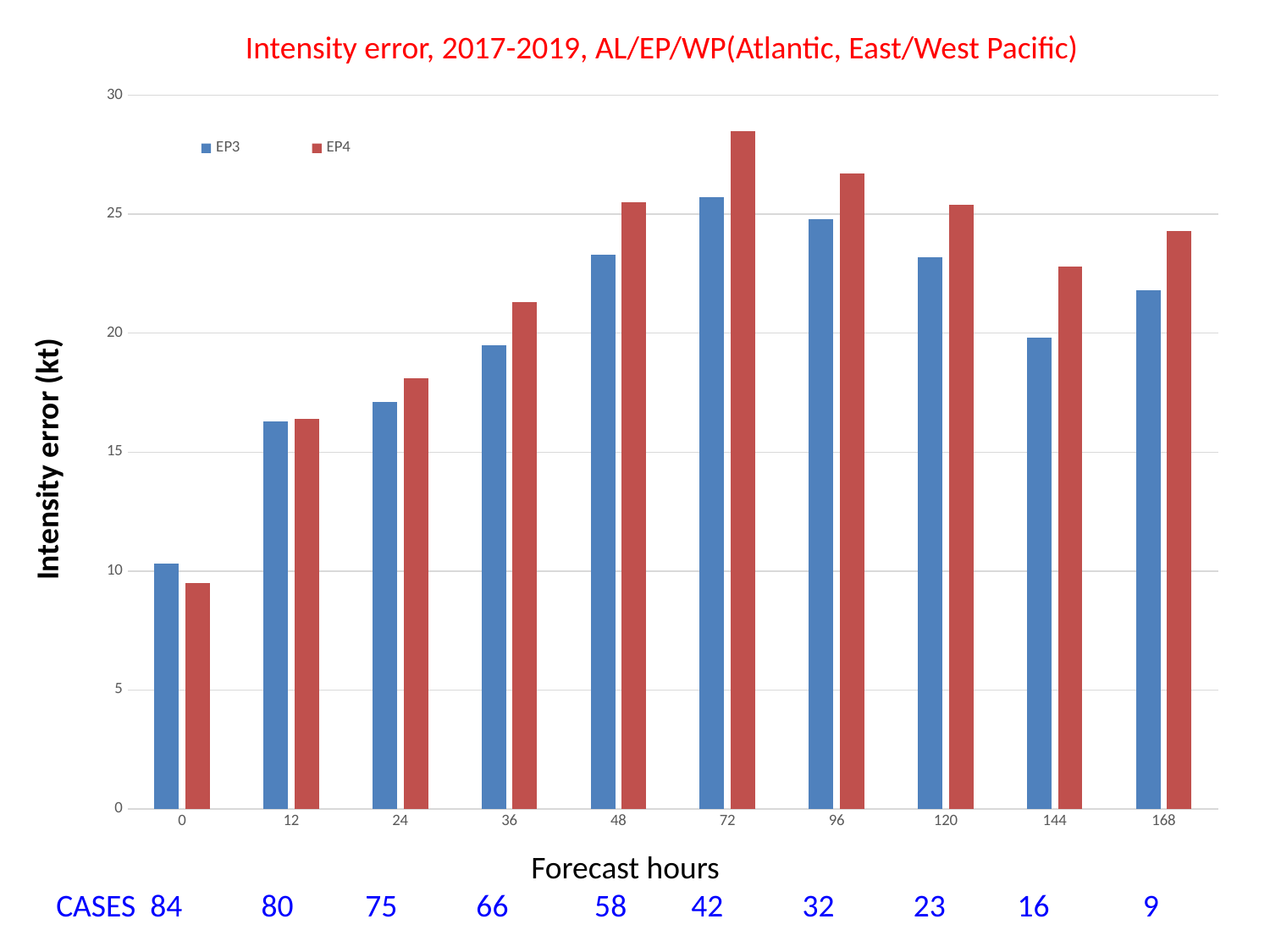
At 168 forecast hours, which series has the larger intensity error, EP3 or EP4? EP4 Do the EP4 values rise or fall from 0 to 72 forecast hours? rise What is the label on the y axis? Intensity error (kt) Is the EP4 value at 72 forecast hours greater or less than 25? greater At which forecast hour is the EP3 intensity error lowest? 0 How many series does the legend list? 2 What kind of chart is shown on the slide? bar chart At 0 forecast hours, which series has the larger intensity error, EP3 or EP4? EP3 At which forecast hour is the EP4 intensity error highest? 72 Is the EP4 value at 0 forecast hours greater or less than 10? less Is the EP3 value at 168 forecast hours greater or less than 20? greater How many forecast-hour categories are plotted on the x axis? 10